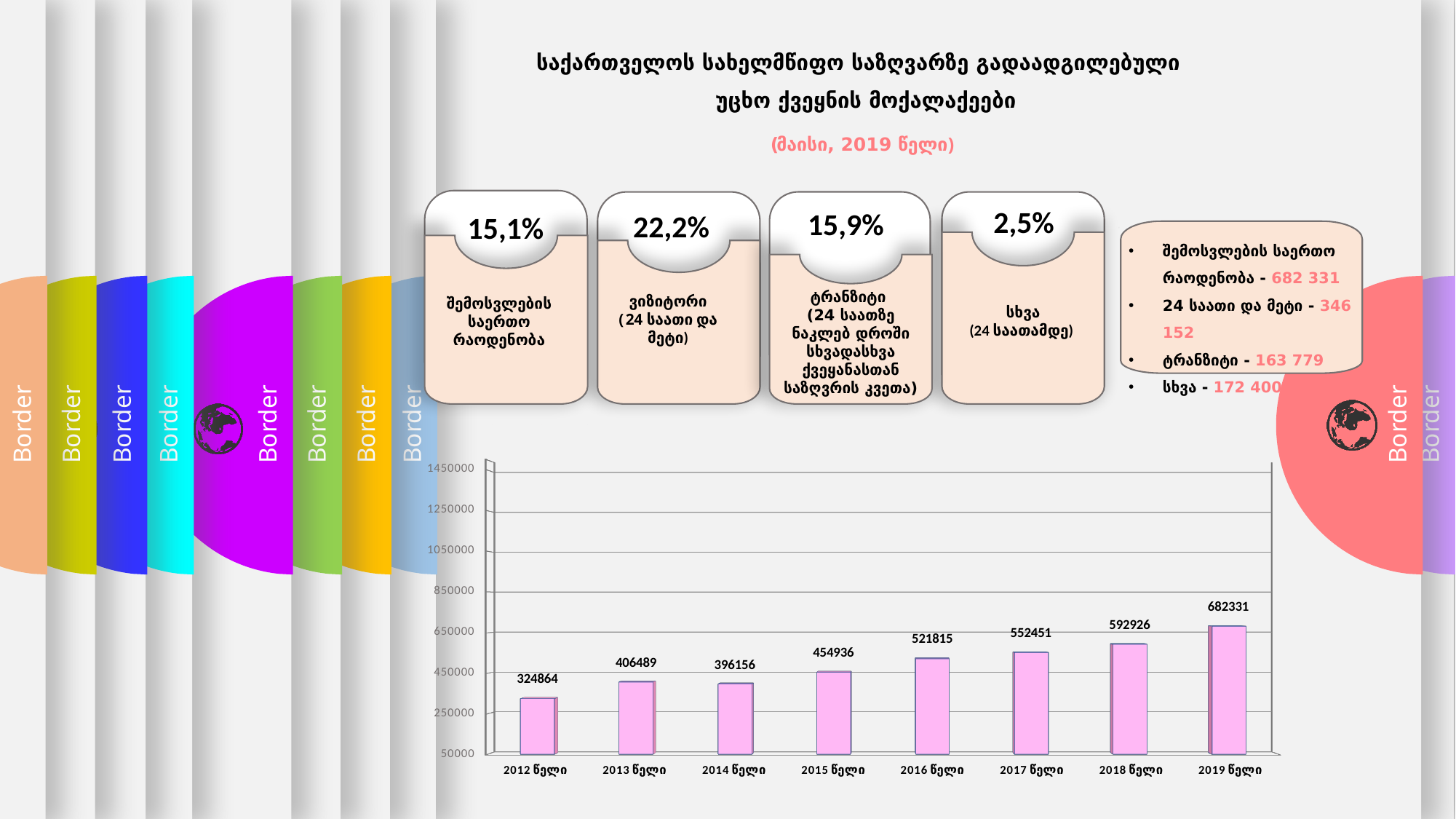
What is the value shown for 2016 in the bar chart? 521815 Which year has the highest value in the bar chart? 2019 What is the difference between the 2019 value and the 2018 value in the bar chart? 89405 What type of chart is shown at the bottom of the slide? bar chart Which is larger in the bar chart, the value for 2013 or the value for 2014? 2013 What is the value shown for 2019 in the bar chart? 682331 Do the values in the bar chart generally rise or fall from 2012 to 2019? rise Which year has the lowest value in the bar chart? 2012 Is the value for 2017 in the bar chart greater or less than 450000? greater What is the value shown for 2012 in the bar chart? 324864 How many years (bars) are plotted in the bar chart? 8 What is the difference between the 2013 value and the 2012 value in the bar chart? 81625